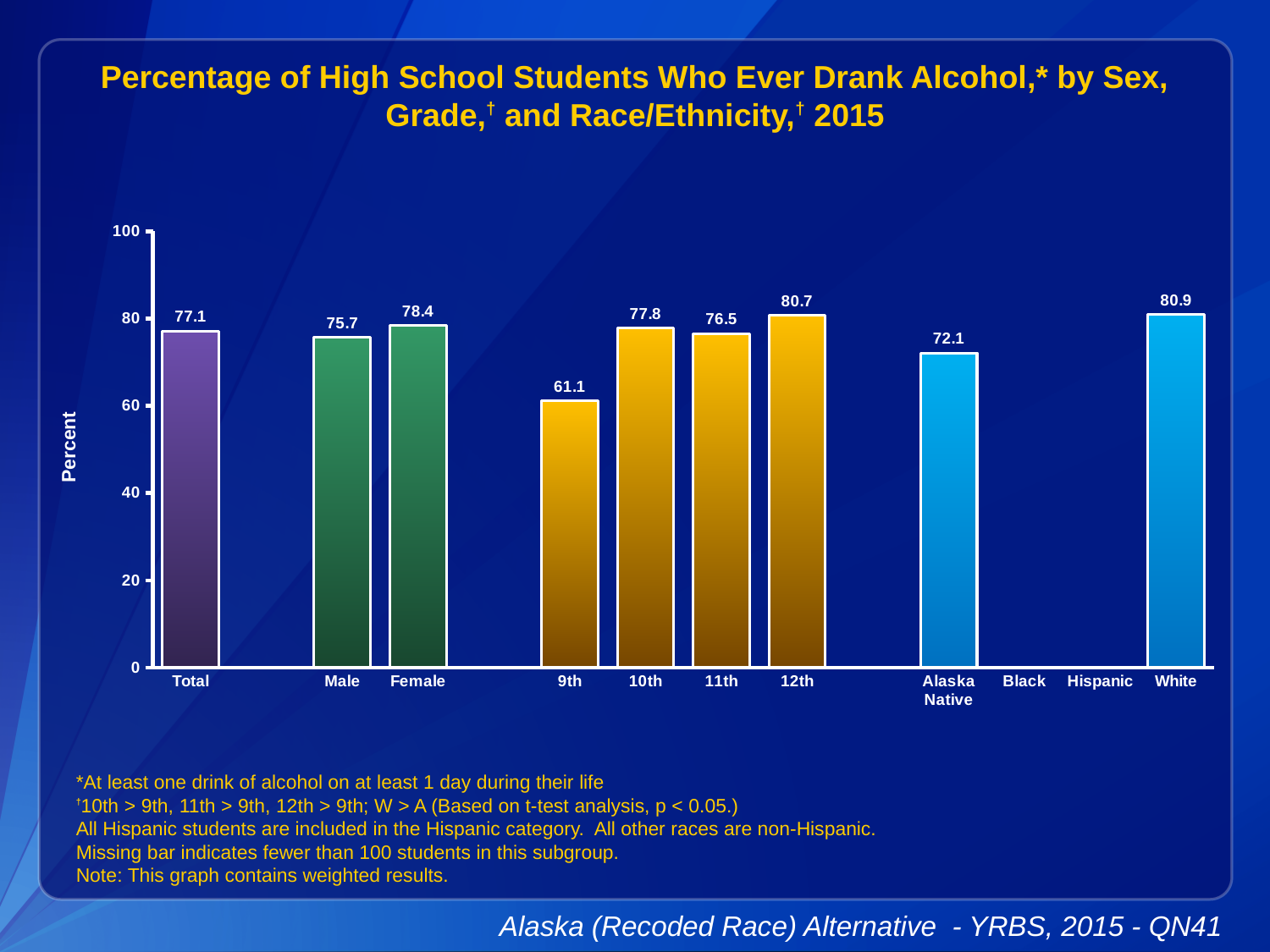
What is the value for Alaska Native? 72.1 What is the difference between the values for 12th and 9th grade? 19.6 What kind of chart is shown? bar chart Is the value for Alaska Native greater or less than 80? less What is the difference between the values for Female and Male? 2.7 What is the value for Total? 77.1 Which is larger, the value for 10th grade or 11th grade? 10th What is the value for 9th grade? 61.1 What is the value for Female? 78.4 How many bars are plotted on the chart? 9 Which category has the highest value? White Which category has the lowest value? 9th